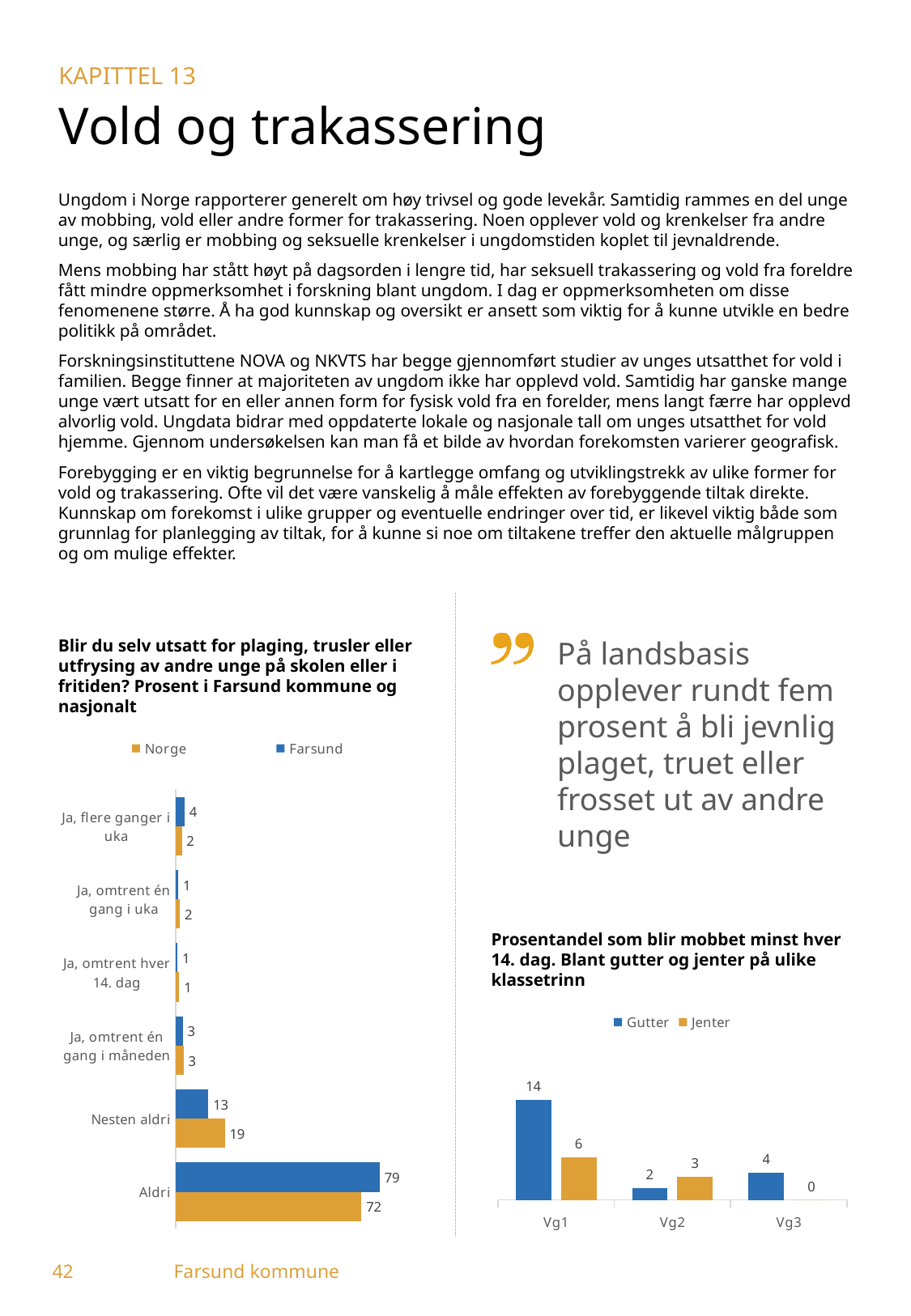
In the chart 'Blir du selv utsatt for plaging, trusler eller utfrysing av andre unge på skolen eller i fritiden?', which category has the highest value for Farsund? Aldri In the chart 'Prosentandel som blir mobbet minst hver 14. dag', what is the difference between Gutter and Jenter at Vg1? 8 In the chart 'Blir du selv utsatt for plaging, trusler eller utfrysing av andre unge på skolen eller i fritiden?', what is the value for Norge in the 'Nesten aldri' category? 19 In the chart 'Blir du selv utsatt for plaging, trusler eller utfrysing av andre unge på skolen eller i fritiden?', what is the value for Farsund in the 'Aldri' category? 79 What kind of chart is 'Blir du selv utsatt for plaging, trusler eller utfrysing av andre unge på skolen eller i fritiden?'? Bar chart In the chart 'Blir du selv utsatt for plaging, trusler eller utfrysing av andre unge på skolen eller i fritiden?', which is larger for 'Ja, flere ganger i uka': Norge or Farsund? Farsund In the chart 'Prosentandel som blir mobbet minst hver 14. dag', which colour represents Jenter? Orange In the chart 'Blir du selv utsatt for plaging, trusler eller utfrysing av andre unge på skolen eller i fritiden?', what is the difference between Farsund and Norge for 'Aldri'? 7 In the chart 'Prosentandel som blir mobbet minst hver 14. dag', what is the value for Jenter at Vg3? 0 In the chart 'Blir du selv utsatt for plaging, trusler eller utfrysing av andre unge på skolen eller i fritiden?', how many categories are shown? 6 In the chart 'Prosentandel som blir mobbet minst hver 14. dag', what is the value for Gutter at Vg1? 14 In the chart 'Blir du selv utsatt for plaging, trusler eller utfrysing av andre unge på skolen eller i fritiden?', how many series does the legend list? 2